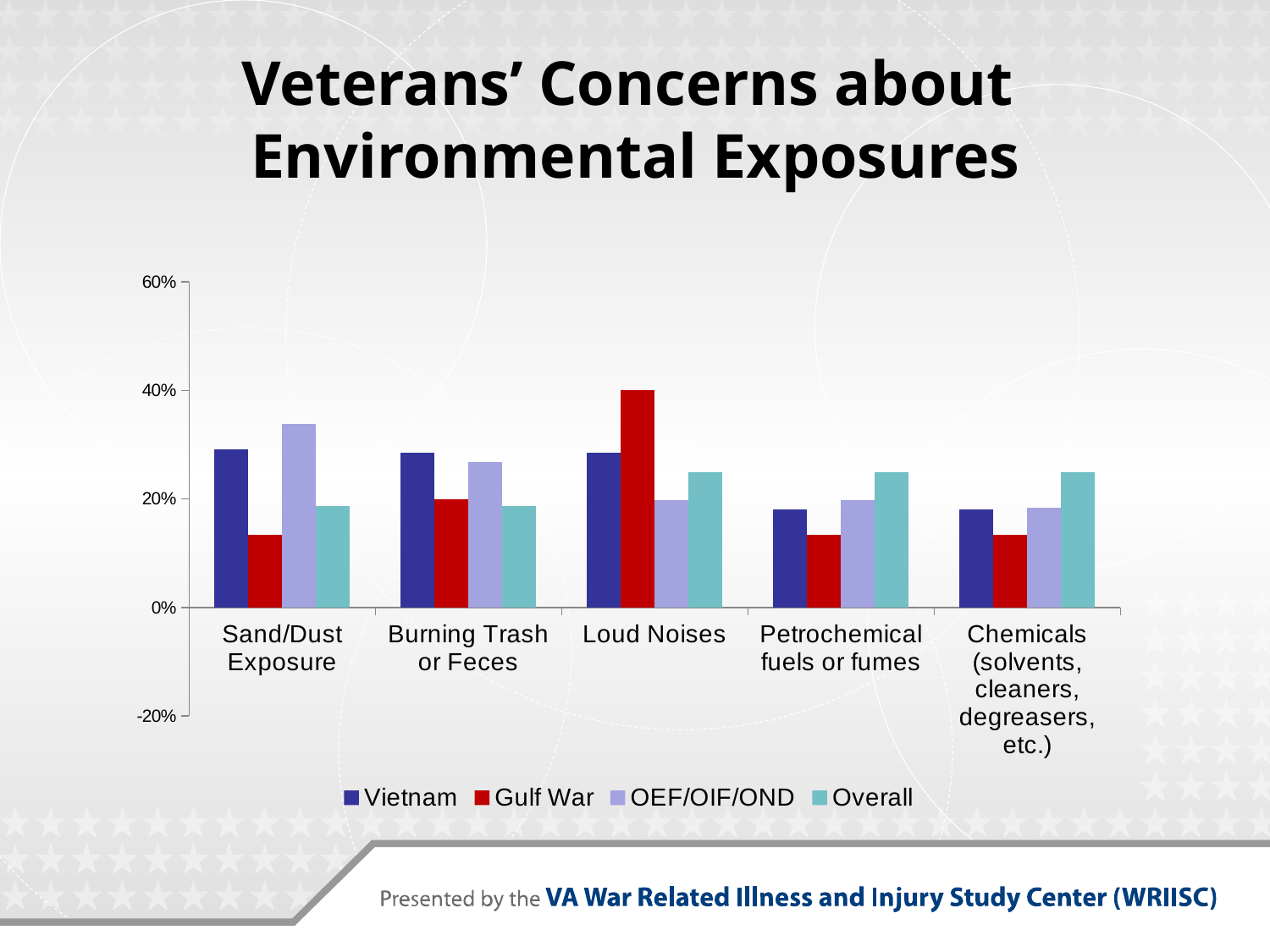
Is the Gulf War value for Sand/Dust Exposure greater or less than 20%? less Which series has the lowest bar for Sand/Dust Exposure? Gulf War For Sand/Dust Exposure, which is larger: the Vietnam value or the Gulf War value? Vietnam Which series has the highest bar for Loud Noises? Gulf War How many exposure categories are shown on the x axis? 5 Which series has the highest bar for Sand/Dust Exposure? OEF/OIF/OND What is the title of the slide containing the chart? Veterans' Concerns about Environmental Exposures How many series does the legend list? 4 For which category is the Gulf War value highest? Loud Noises What kind of chart is shown on the slide? Bar chart Is the Gulf War value for Loud Noises greater or less than 20%? greater Is the Vietnam value for Burning Trash or Feces greater or less than 20%? greater